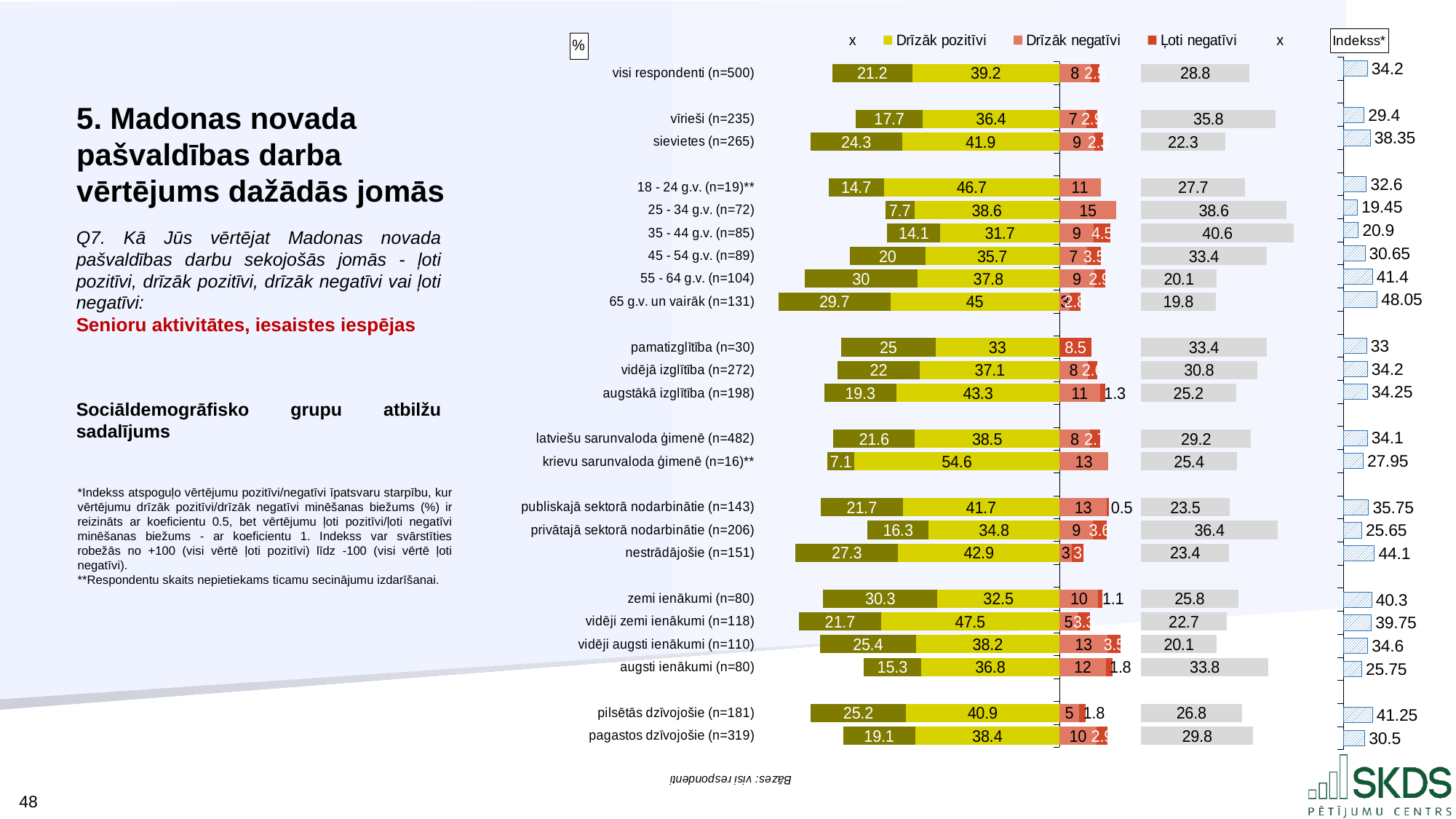
Which group has the larger 'Drīzāk pozitīvi' value: 'latviešu sarunvaloda ģimenē (n=482)' or 'krievu sarunvaloda ģimenē (n=16)**'? krievu sarunvaloda ģimenē (n=16)** What is the difference between the Indekss* values for 'sievietes (n=265)' and 'vīrieši (n=235)'? 8.95 What kind of chart is used to show the respondent groups' ratings? Stacked bar chart Which respondent group has the lowest Indekss* value? 25 - 34 g.v. (n=72) What is the value of the grey segment for '35 - 44 g.v. (n=85)'? 40.6 How many respondent groups (categories) are shown in the chart? 23 What is the 'Drīzāk negatīvi' value for 'publiskajā sektorā nodarbinātie (n=143)'? 13 What is the value of the dark olive (leftmost) segment for '55 - 64 g.v. (n=104)'? 30 Which respondent group has the highest 'Drīzāk pozitīvi' value? krievu sarunvaloda ģimenē (n=16)** Which respondent group has the highest Indekss* value? 65 g.v. un vairāk (n=131) What is the Indekss* value for '65 g.v. un vairāk (n=131)'? 48.05 What is the 'Drīzāk pozitīvi' value for 'visi respondenti (n=500)'? 39.2